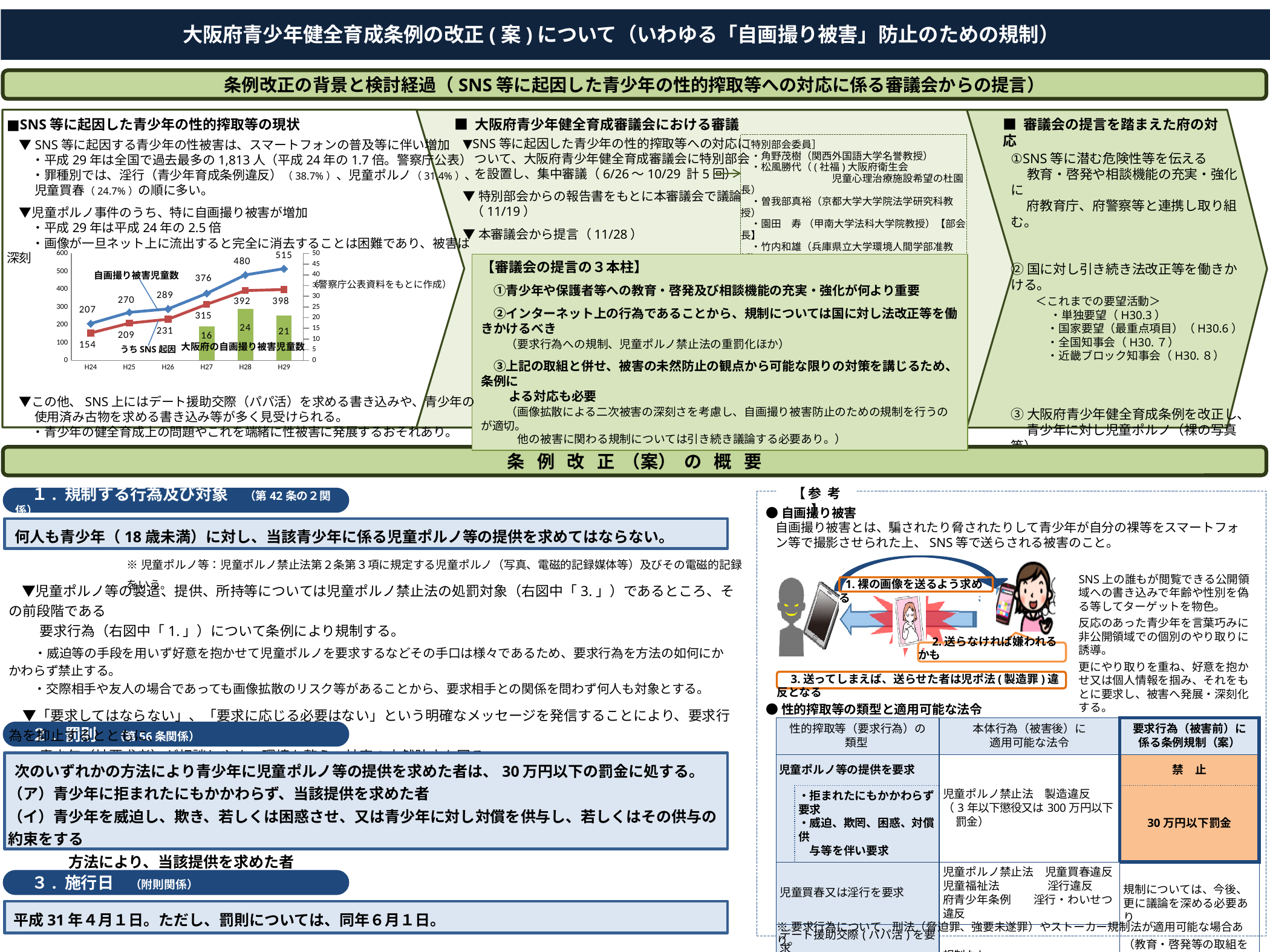
What is the value of 自画撮り被害児童数 for H29? 515 Does 自画撮り被害児童数 rise or fall from H24 to H29? rise What is the difference between 自画撮り被害児童数 in H29 and in H24? 308 What is the value of 自画撮り被害児童数 for H27? 376 What is the value of 大阪府の自画撮り被害児童数 for H28? 24 What is the difference between 自画撮り被害児童数 and うちSNS起因 in H29? 117 How many years are shown on the x axis of the chart? 6 In which year is 自画撮り被害児童数 highest? H29 Which is larger, 大阪府の自画撮り被害児童数 in H28 or in H29? H28 What is the value of うちSNS起因 for H24? 154 In which year is うちSNS起因 lowest? H24 What kind of chart is shown on the slide? combined line and bar chart